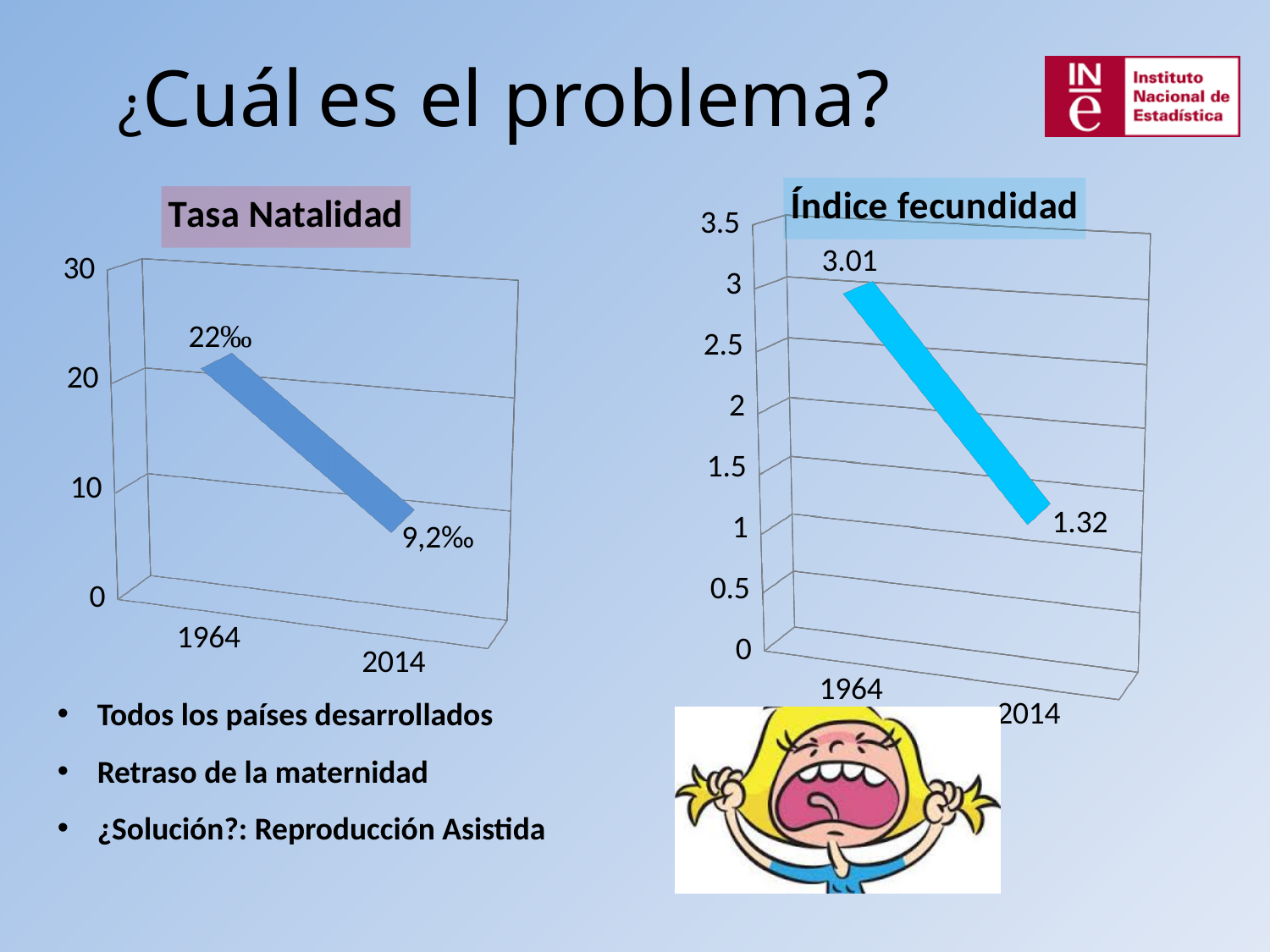
What kind of chart is the 'Índice fecundidad' chart? line chart In the 'Índice fecundidad' chart, what is the value for 2014? 1.32 How many data points are plotted in the 'Índice fecundidad' chart? 2 In the 'Índice fecundidad' chart, is the value for 1964 greater or less than 3? greater In the 'Tasa Natalidad' chart, what is the value for 1964? 22‰ In the 'Índice fecundidad' chart, what is the value for 1964? 3.01 In the 'Tasa Natalidad' chart, is the value for 2014 greater or less than 10? less In the 'Tasa Natalidad' chart, do the values rise or fall from 1964 to 2014? fall In the 'Tasa Natalidad' chart, which year has the higher value? 1964 In the 'Índice fecundidad' chart, which year has the lower value? 2014 In the 'Tasa Natalidad' chart, what is the value for 2014? 9,2‰ In the 'Índice fecundidad' chart, what is the difference between the 1964 and 2014 values? 1.69